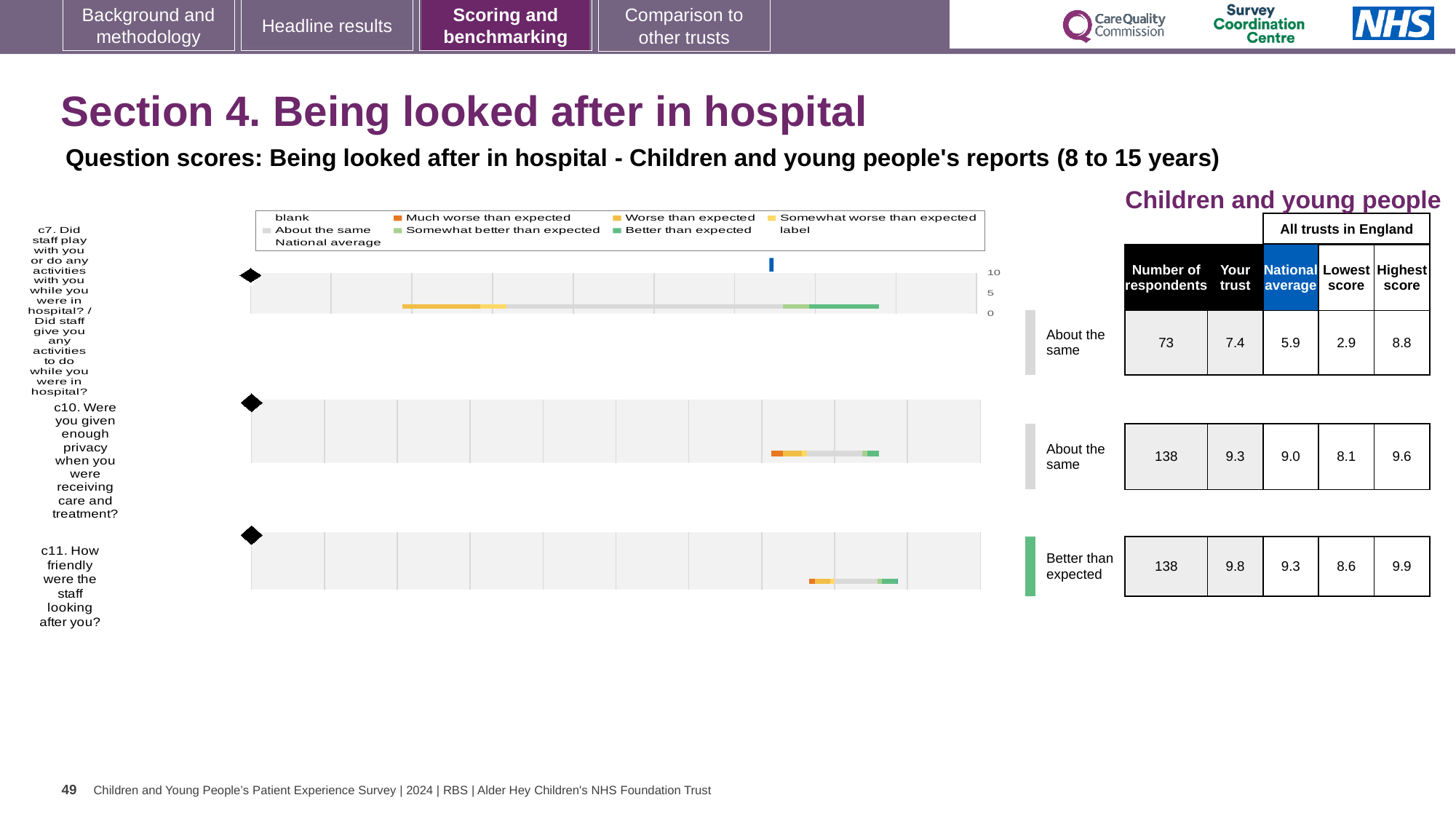
How many questions are plotted in the chart? 3 What is the 'Your trust' score for c11 (How friendly were the staff looking after you?)? 9.8 Which question has the highest 'Your trust' score? c11 For c10, which is larger: the 'Your trust' score or the national average? Your trust What is the national average score for c10 (Were you given enough privacy when you were receiving care and treatment?)? 9.0 What is the difference between the 'Your trust' score and the national average for c11? 0.5 What kind of chart is used to show the question scores for Being looked after in hospital? Bar chart How many respondents answered c7 (Did staff play with you or do any activities with you while you were in hospital?)? 73 What benchmark category is shown for c11 (How friendly were the staff looking after you?)? Better than expected What is the highest score across all trusts in England for c7? 8.8 What is the lowest score across all trusts in England for c10? 8.1 Which question has the lowest 'Your trust' score? c7